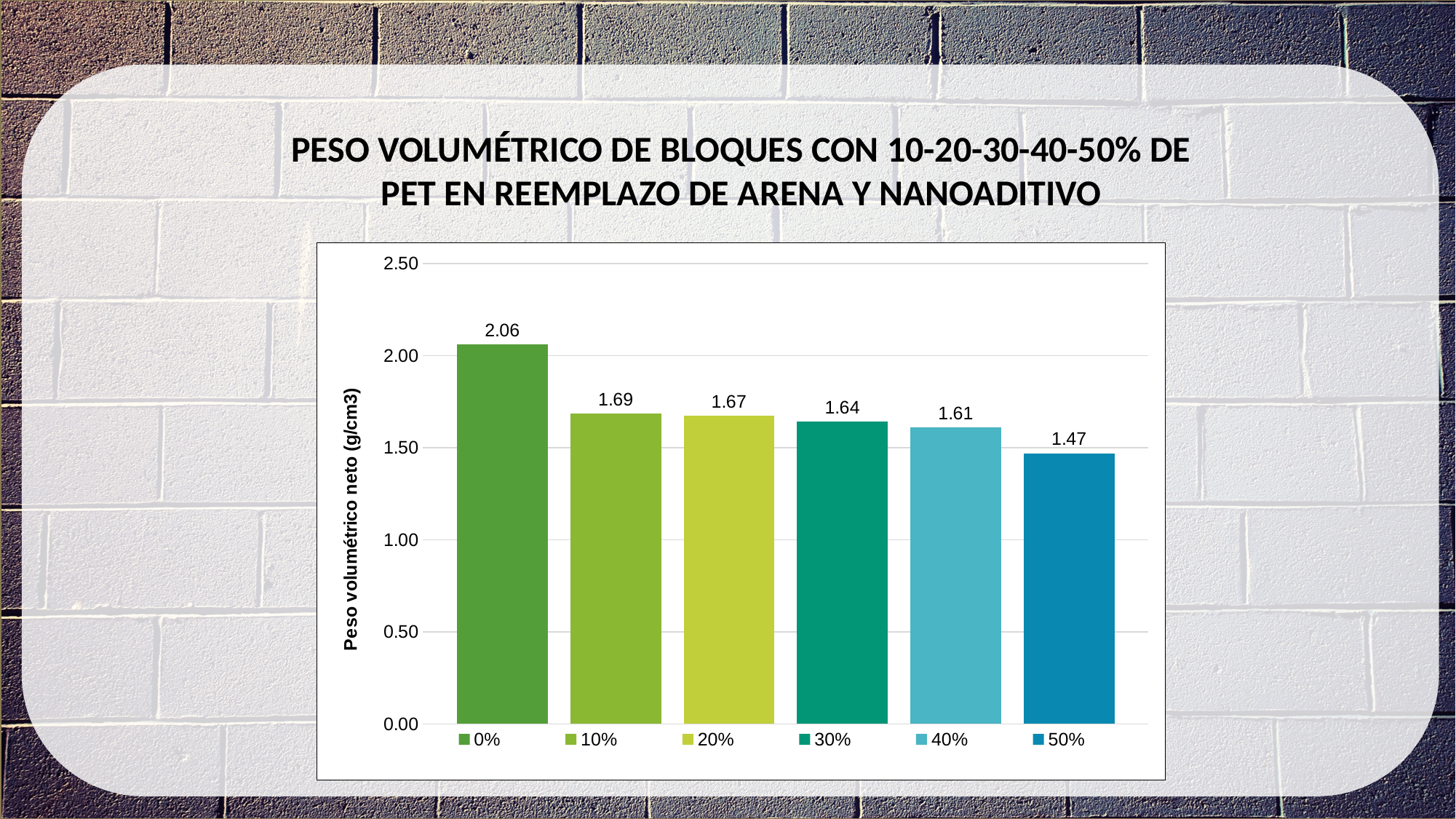
Do the values rise or fall from 0% to 50%? fall What is the difference between the values for 10% and 40%? 0.08 What is the value for 0%? 2.06 Which category has the lowest value? 50% Which is larger, the value for 20% or the value for 50%? 20% What kind of chart is shown on the slide? bar chart What is the value for 30%? 1.64 Which category has the highest value? 0% What is the difference between the values for 0% and 50%? 0.59 How many bars are shown in the chart? 6 What is the value for 50%? 1.47 Is the value for 40% greater or less than 2.00? less